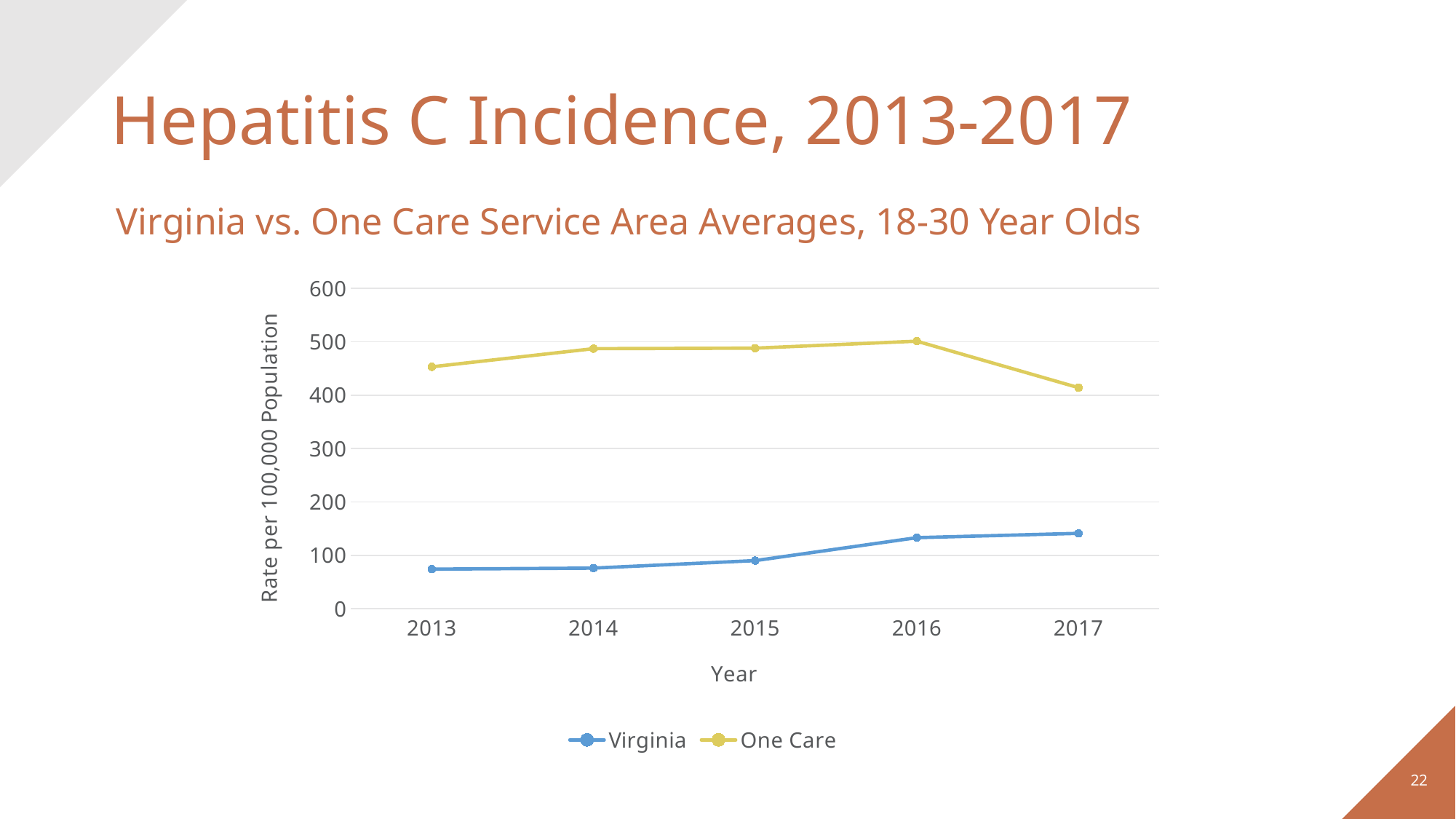
In which year is the One Care rate at its highest? 2016 Is the Virginia value for 2016 greater or less than 100? greater How many series does the legend list? 2 In which year is the One Care rate at its lowest? 2017 What kind of chart is shown on the slide? line chart Does the Virginia rate rise or fall from 2013 to 2017? rise Is the One Care value for 2017 greater or less than 500? less How many years are plotted along the x axis? 5 Is the One Care value for 2013 greater or less than 400? greater What is the label on the y axis? Rate per 100,000 Population Which series has the higher rate in 2015, Virginia or One Care? One Care